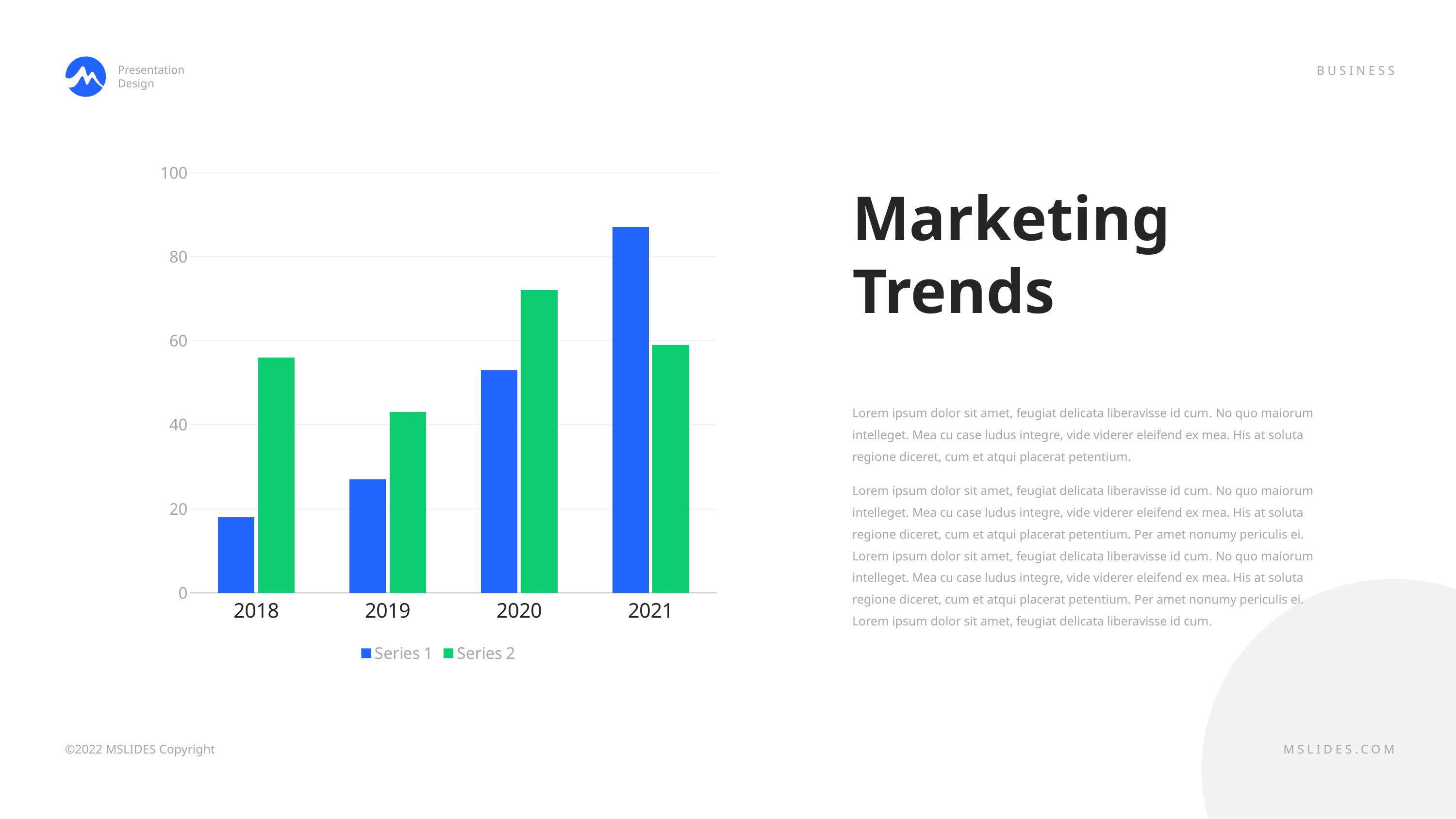
Which year has the highest value for Series 1? 2021 In 2018, which is larger, Series 1 or Series 2? Series 2 How many categories are shown on the x axis? 4 What kind of chart is shown on the slide? bar chart Is the value for Series 2 in 2020 greater or less than 60? greater Is the value for Series 1 in 2021 greater or less than 80? greater Which year has the lowest value for Series 1? 2018 How many series does the legend list? 2 Which year has the lowest value for Series 2? 2019 Do the Series 1 values rise or fall from 2018 to 2021? rise Which year has the highest value for Series 2? 2020